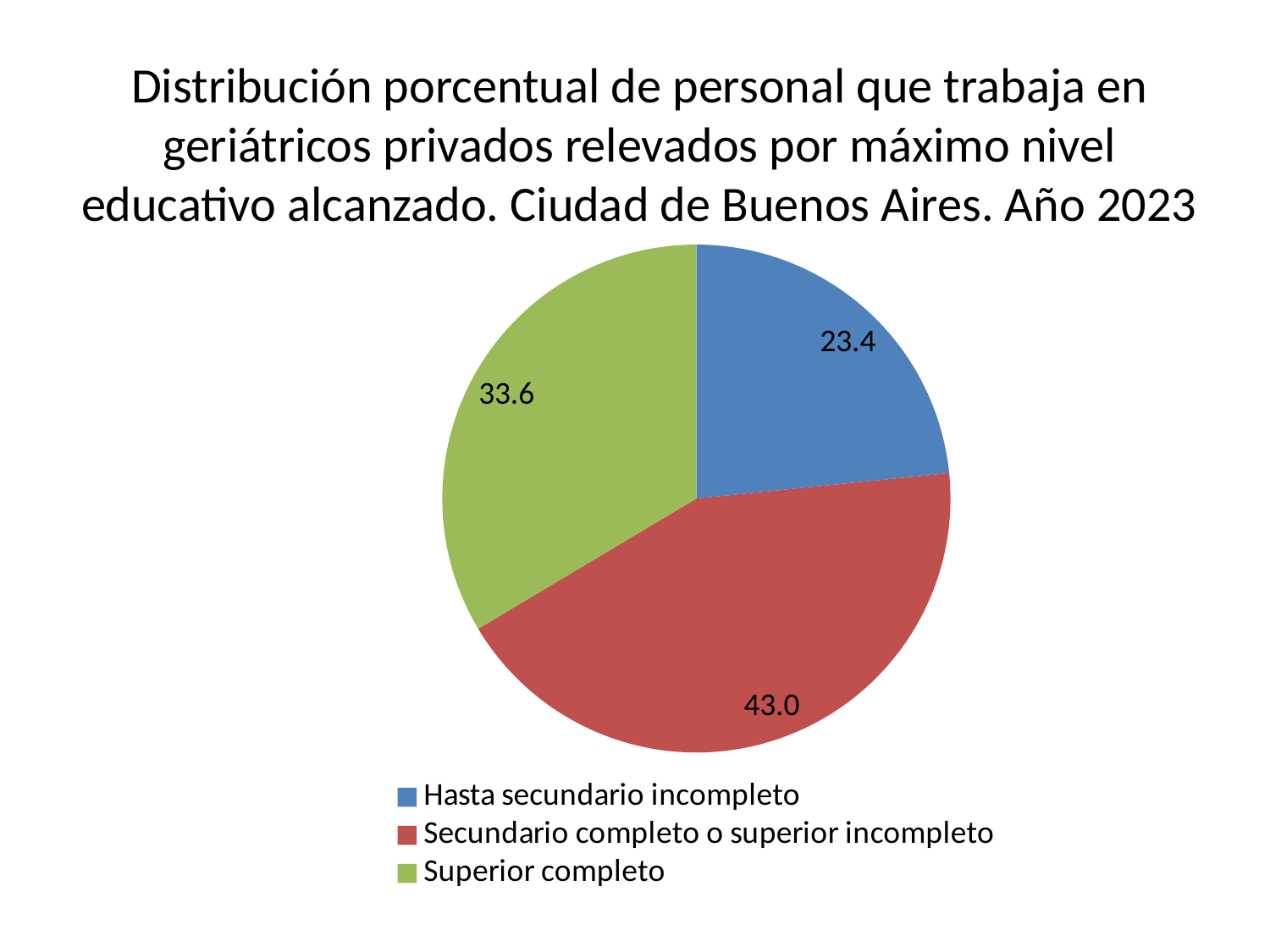
What type of chart is shown on the slide? Pie chart Which year does the chart title refer to? 2023 Which category has the smallest share of the pie? Hasta secundario incompleto What is the difference between the values for 'Secundario completo o superior incompleto' and 'Superior completo'? 9.4 What is the value for 'Superior completo'? 33.6 What is the difference between the values for 'Superior completo' and 'Hasta secundario incompleto'? 10.2 Which is larger: the value for 'Superior completo' or the value for 'Hasta secundario incompleto'? Superior completo How many categories does the pie chart have? 3 What colour is the slice for 'Superior completo'? Green Which category has the largest share of the pie? Secundario completo o superior incompleto What is the value for 'Hasta secundario incompleto'? 23.4 What is the value for 'Secundario completo o superior incompleto'? 43.0